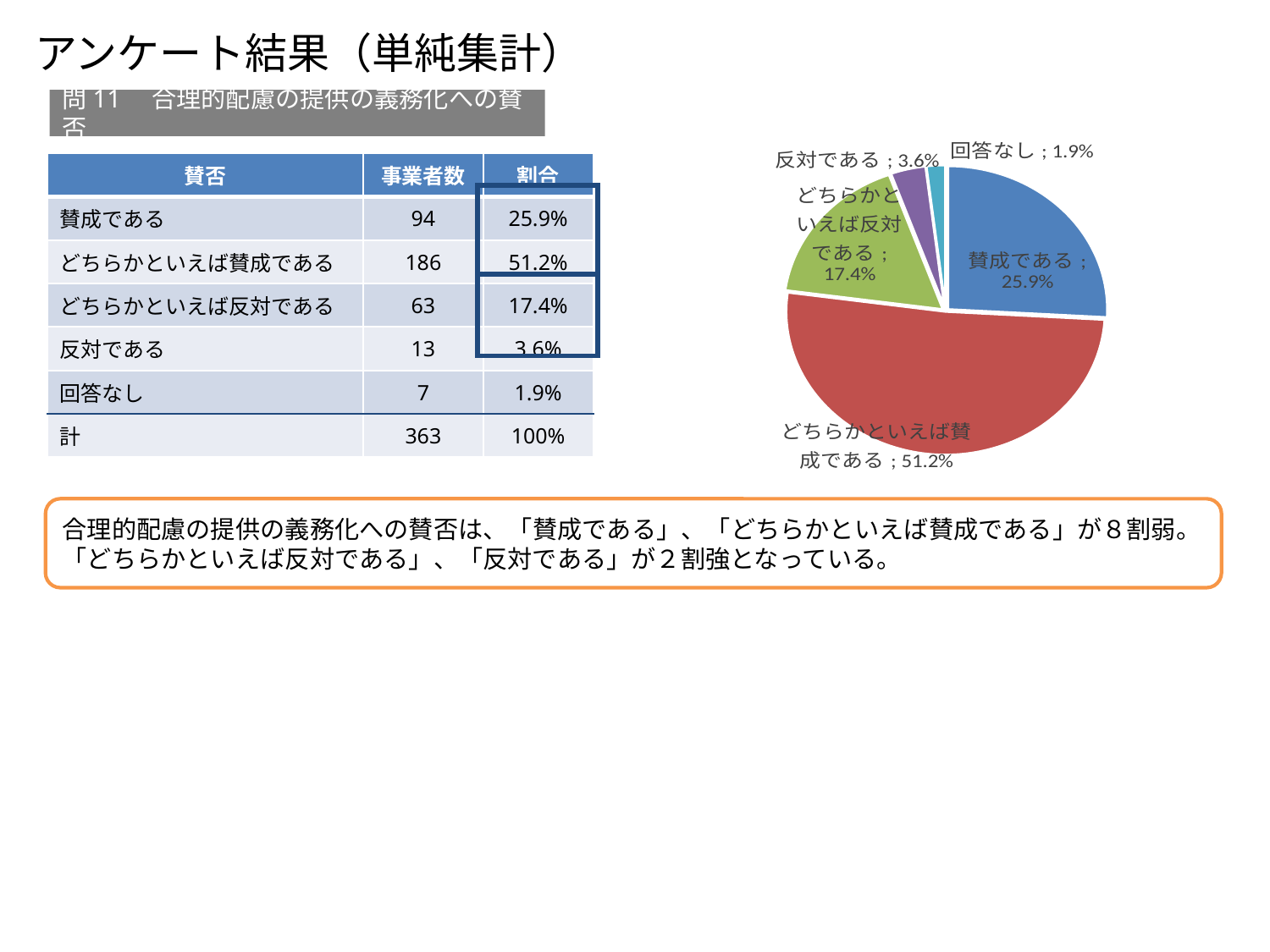
What share of the pie does 「どちらかといえば賛成である」 represent? 51.2% What is the difference in percentage points between 「どちらかといえば賛成である」 and 「賛成である」? 25.3 What share of the pie does 「賛成である」 represent? 25.9% What colour is the 「どちらかといえば賛成である」 slice in the pie chart? red What share of the pie does 「反対である」 represent? 3.6% Which is larger in the pie chart, 「賛成である」 or 「どちらかといえば反対である」? 賛成である What kind of chart is shown on the slide? pie chart How many slices does the pie chart have? 5 Which category has the smallest slice in the pie chart? 回答なし Which category has the largest slice in the pie chart? どちらかといえば賛成である